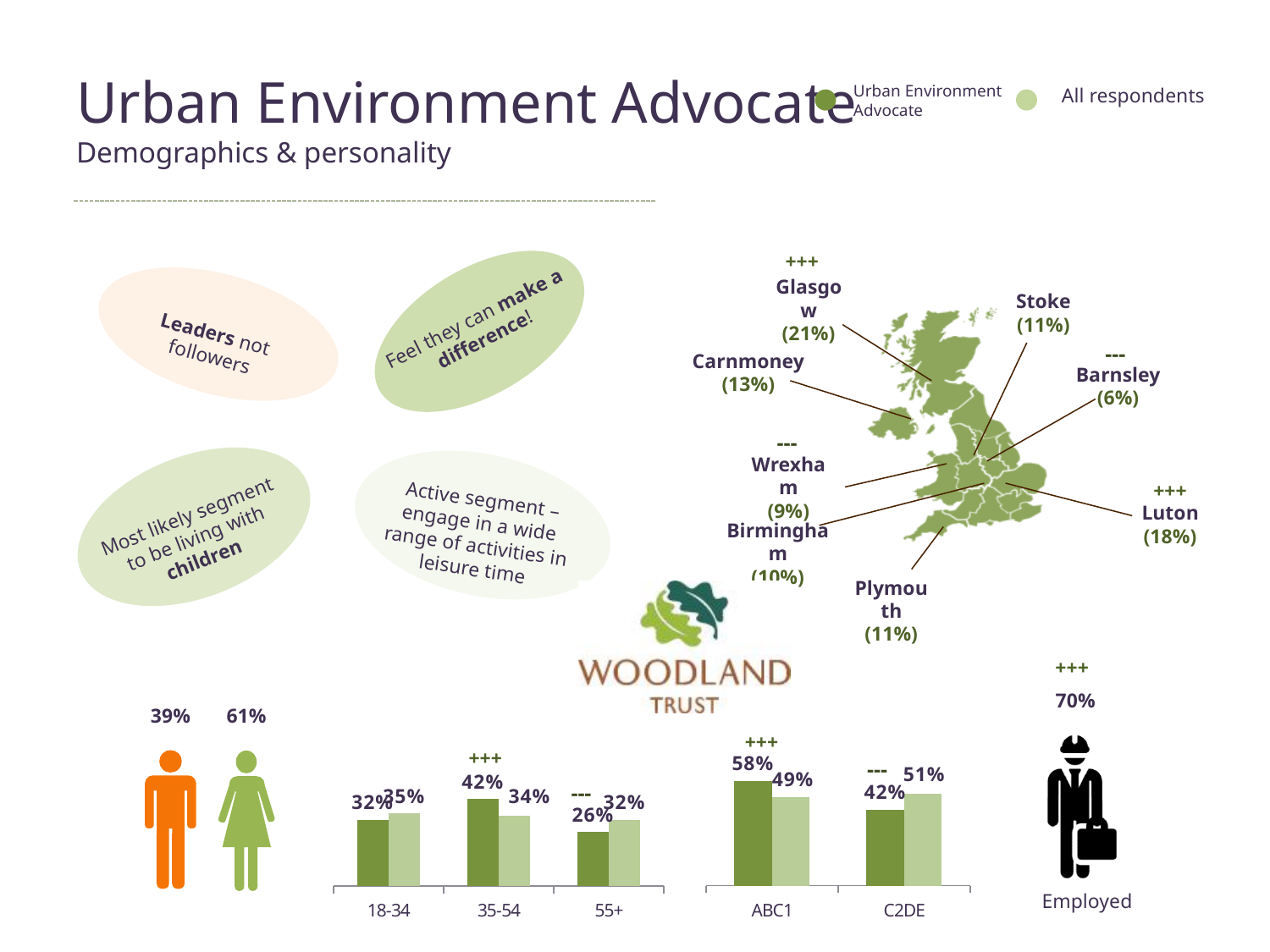
In the social-grade bar chart, which is larger for C2DE: the Urban Environment Advocate value or the All respondents value? All respondents In the age-group bar chart, what is the value for All respondents in the 18-34 category? 35% In the social-grade bar chart, what is the value for Urban Environment Advocate in the ABC1 category? 58% In the age-group bar chart, which age category has the highest Urban Environment Advocate value? 35-54 In the age-group bar chart, what is the value for Urban Environment Advocate in the 35-54 category? 42% How many series does the legend at the top of the slide list? 2 In the social-grade bar chart, what is the value for All respondents in the C2DE category? 51% In the age-group bar chart, what is the value for All respondents in the 55+ category? 32% In the social-grade bar chart, what is the difference between the Urban Environment Advocate and All respondents values for ABC1? 9% In the age-group bar chart, how many age categories are shown on the x axis? 3 In the age-group bar chart, which age category has the lowest Urban Environment Advocate value? 55+ In the age-group bar chart, what is the difference between the Urban Environment Advocate and All respondents values for 35-54? 8%